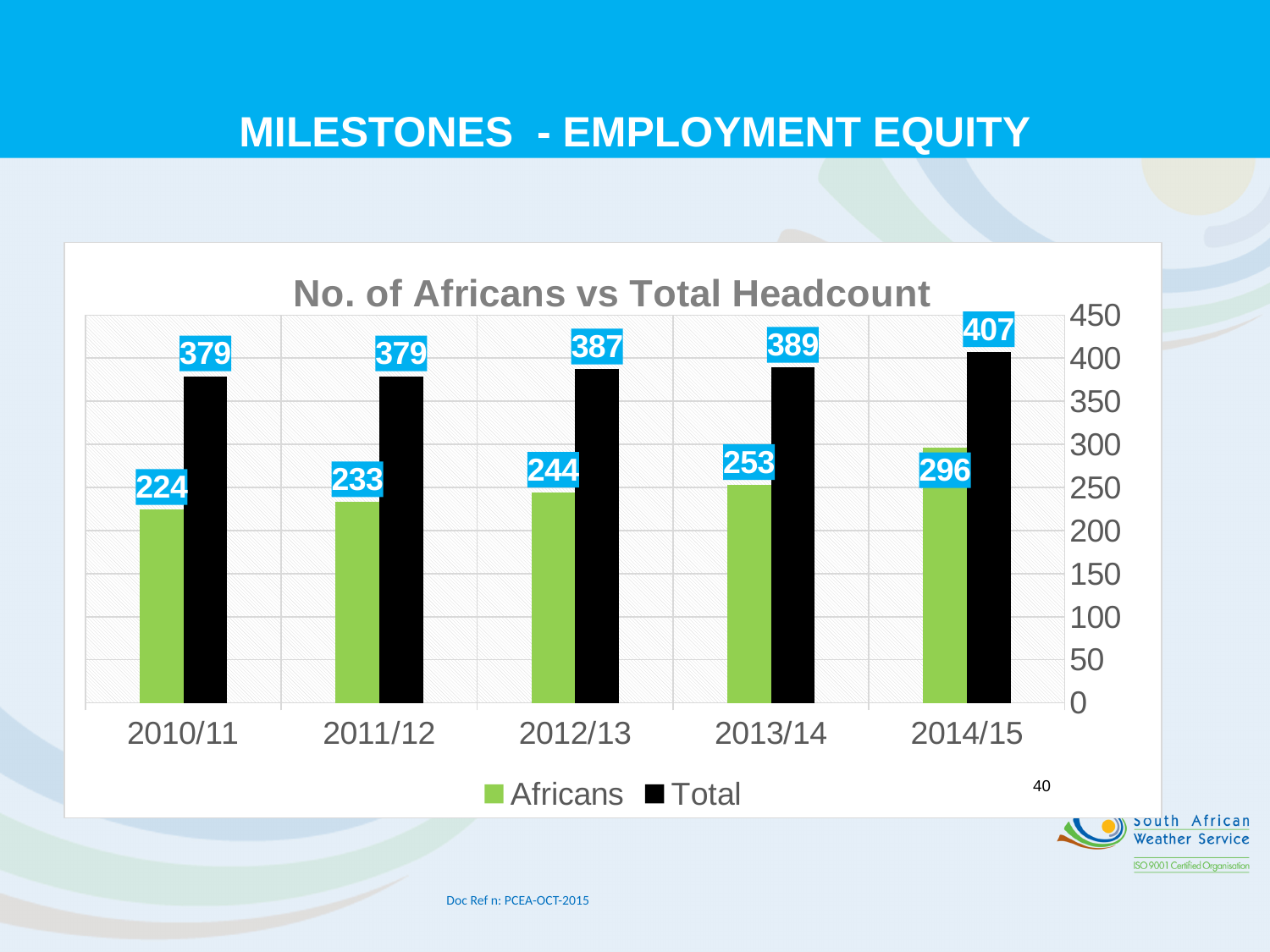
Which year has the lowest Total headcount? 2010/11 and 2011/12 What is the difference between the Total headcount and the number of Africans in 2012/13? 143 Which year has the highest number of Africans? 2014/15 How many years are shown on the x axis? 5 What is the number of Africans in 2010/11? 224 What is the number of Africans in 2013/14? 253 What kind of chart is shown? bar chart Is the number of Africans in 2012/13 greater or less than 200? greater Does the Total headcount rise or fall from 2011/12 to 2014/15? rise Which is larger: the number of Africans in 2014/15 or the number of Africans in 2011/12? 2014/15 How many series does the legend list? 2 What is the Total headcount in 2014/15? 407